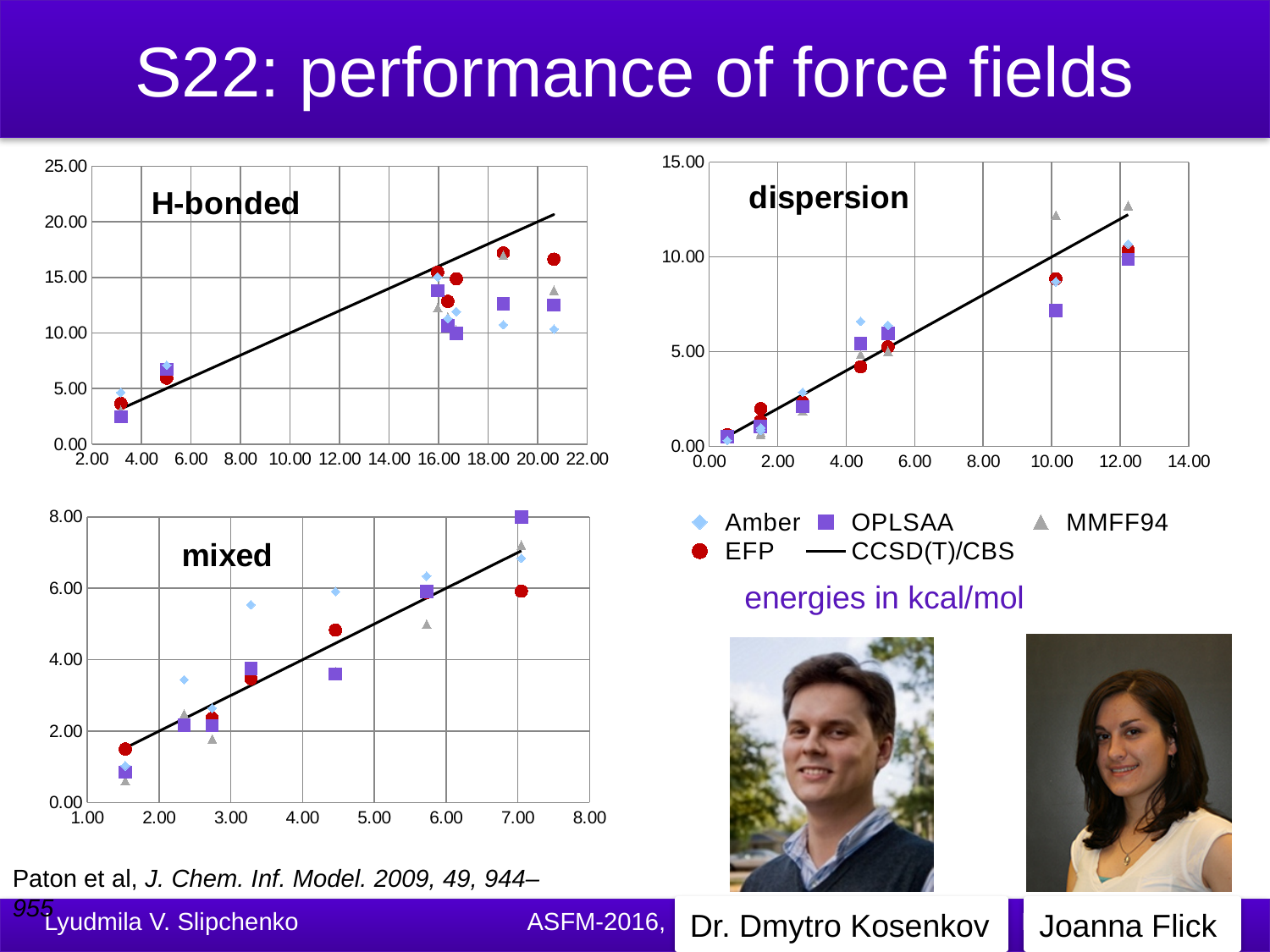
In the dispersion chart, is the rightmost MMFF94 point (near x = 12.00) greater or less than 10.00? greater In the H-bonded chart, is the rightmost EFP point (near x = 20.00) greater or less than 15.00? greater In the dispersion chart, near x = 10.00, which is higher: the OPLSAA point or the EFP point? EFP In the H-bonded chart, is the rightmost OPLSAA point (near x = 20.00) greater or less than 15.00? less What kind of chart is the H-bonded chart? scatter chart How many series does the legend list? 5 How many charts are shown on the slide? 3 In the dispersion chart, does the CCSD(T)/CBS line rise or fall as x increases? rises Which series are listed in the legend? Amber, OPLSAA, MMFF94, EFP, CCSD(T)/CBS In what units are the energies plotted, according to the slide? kcal/mol